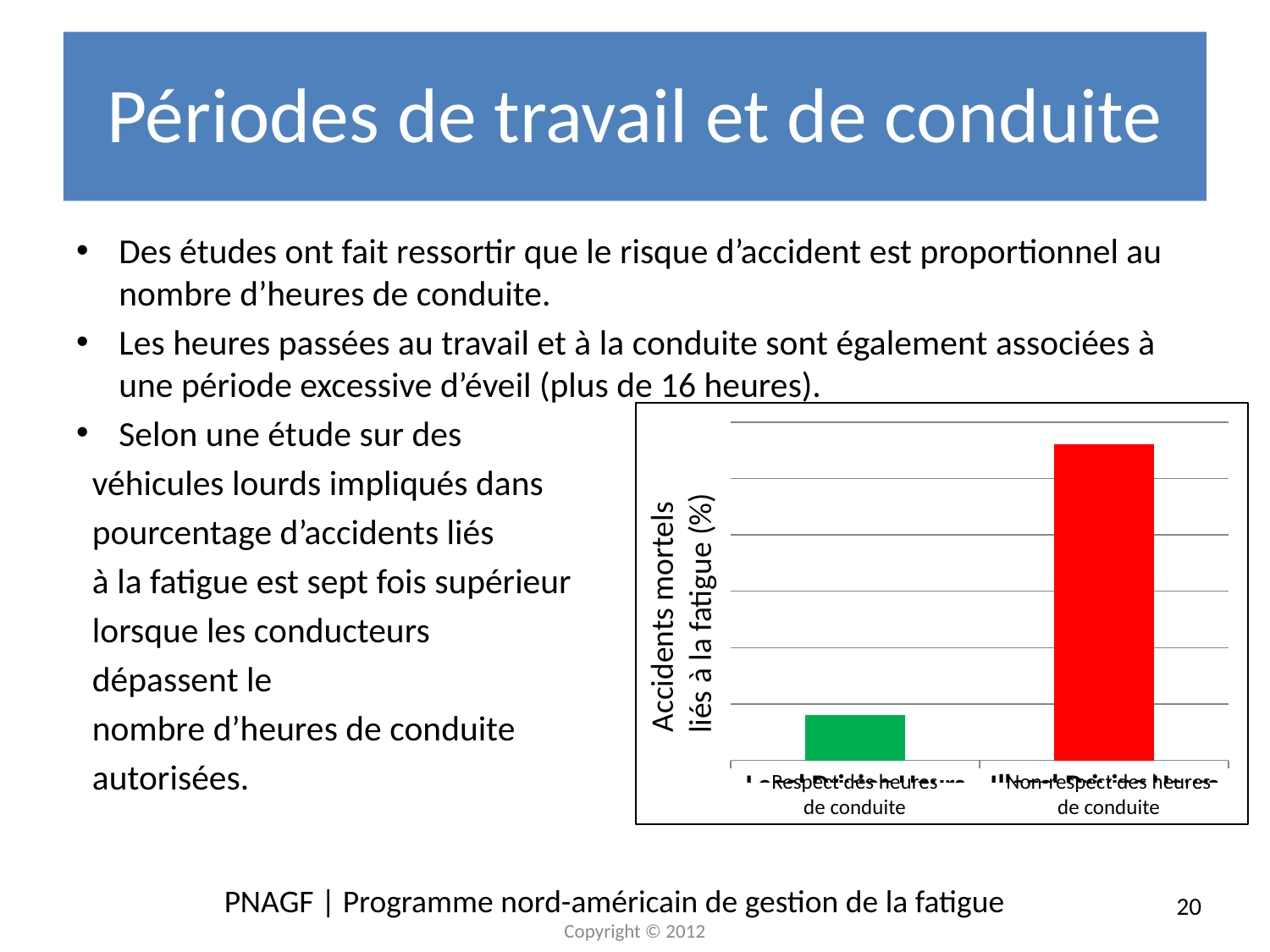
Which category has the highest value in the chart? Non-respect des heures de conduite What is the label of the vertical axis of the chart? Accidents mortels liés à la fatigue (%) Which category has the lowest value in the chart? Respect des heures de conduite Which is larger: the value for "Respect des heures de conduite" or the value for "Non-respect des heures de conduite"? Non-respect des heures de conduite How many categories are plotted in the chart? 2 What kind of chart is shown on the slide? bar chart What colour is the bar for "Non-respect des heures de conduite"? red